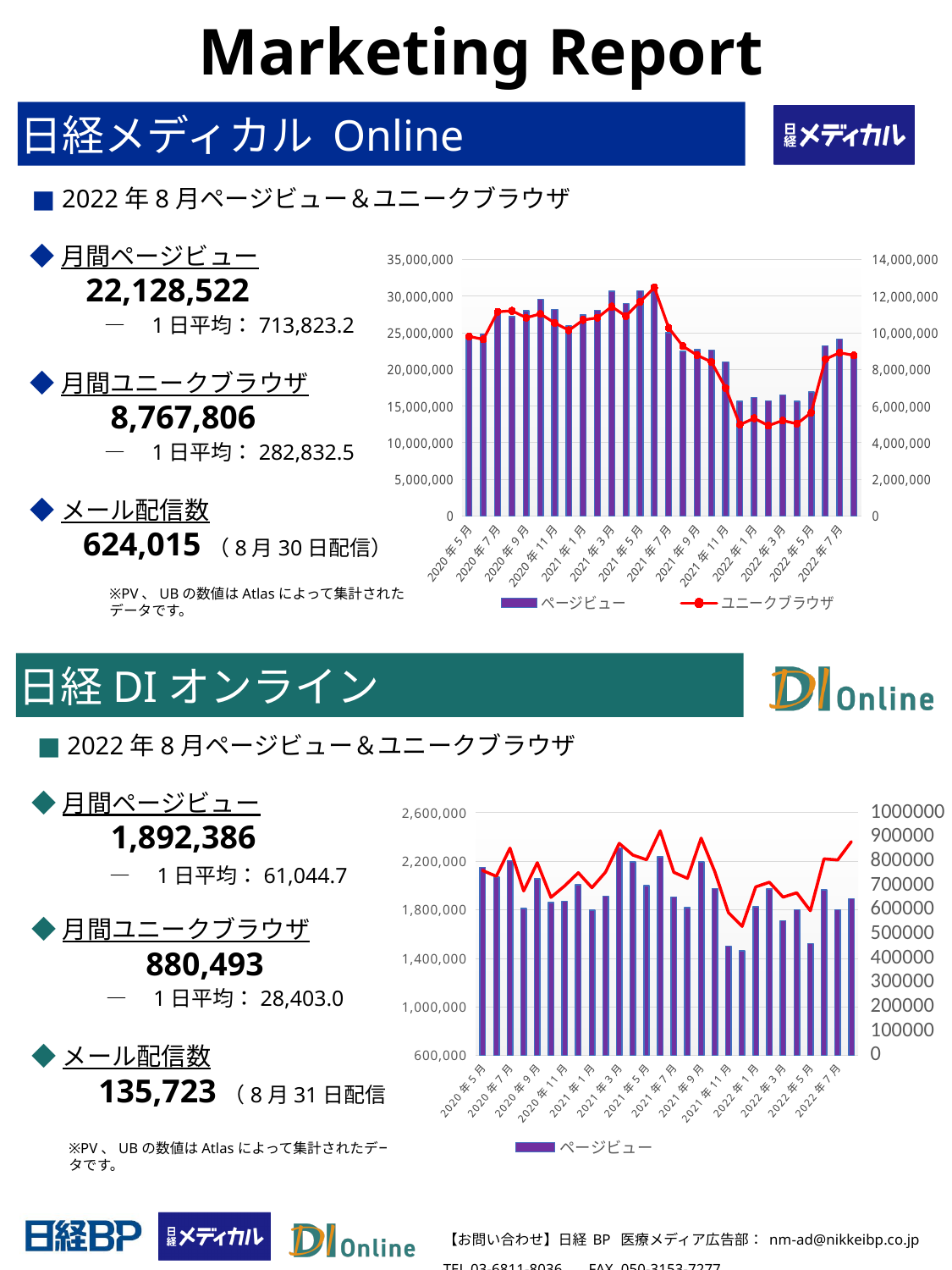
In the top chart (日経メディカル Online), is the page view (ページビュー) value for 2022年1月 greater or less than 20,000,000? less In the bottom chart (日経DIオンライン), which has the larger page view value, 2021年3月 or 2022年1月? 2021年3月 In the top chart (日経メディカル Online), how many series does the legend list? 2 In the top chart (日経メディカル Online), is the unique browser (ユニークブラウザ) value for 2021年7月 greater or less than 12,000,000 on the right axis? less In the bottom chart (日経DIオンライン), is the page view value for 2021年12月 greater or less than 1,800,000? less In the top chart (日経メディカル Online), which has the larger page view value, 2020年5月 or 2022年1月? 2020年5月 In the top chart (日経メディカル Online), what kind of chart is used to show the data? bar chart with a line In the top chart (日経メディカル Online), do the page views rise or fall from 2021年7月 to 2022年1月? fall In the bottom chart (日経DIオンライン), which month has the highest page view (ページビュー) value? 2021年3月 In the top chart (日経メディカル Online), what are the two legend entries? ページビュー and ユニークブラウザ